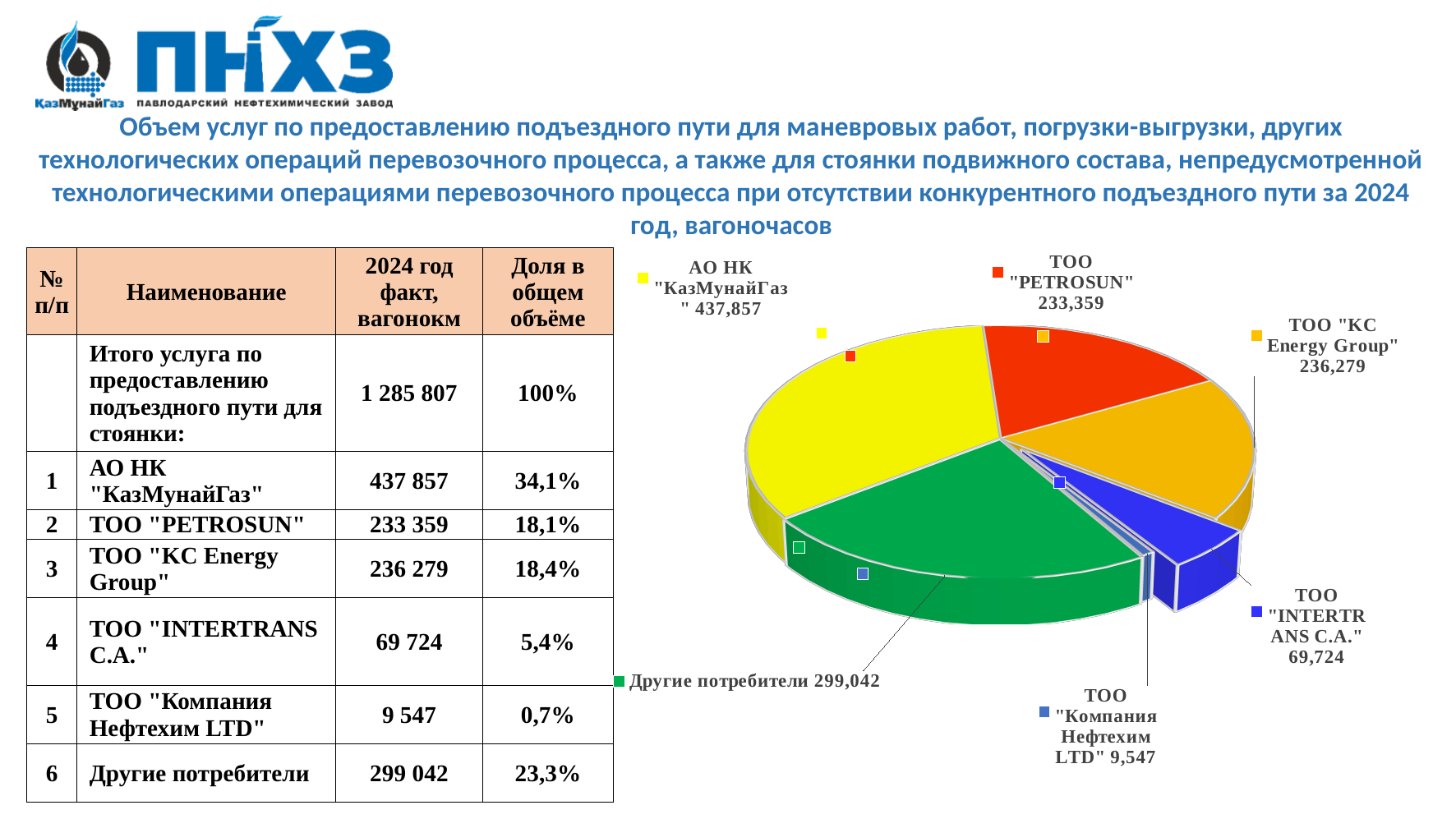
What is the difference between the values for ТОО "KC Energy Group" and ТОО "PETROSUN" in the pie chart? 2,920 What is the value shown for ТОО "PETROSUN" in the pie chart? 233,359 Which category has the largest slice in the pie chart? АО НК "КазМунайГаз" Which category has the smallest slice in the pie chart? ТОО "Компания Нефтехим LTD" What is the value shown for ТОО "INTERTRANS C.A." in the pie chart? 69,724 What share of the total does АО НК "КазМунайГаз" account for, according to the slide? 34,1% What is the value shown for ТОО "Компания Нефтехим LTD" in the pie chart? 9,547 What is the value shown for Другие потребители in the pie chart? 299,042 How many slices does the pie chart have? 6 What kind of chart is shown on the slide? pie chart Which is larger in the pie chart: ТОО "PETROSUN" or ТОО "KC Energy Group"? ТОО "KC Energy Group" What is the value shown for АО НК "КазМунайГаз" in the pie chart? 437,857